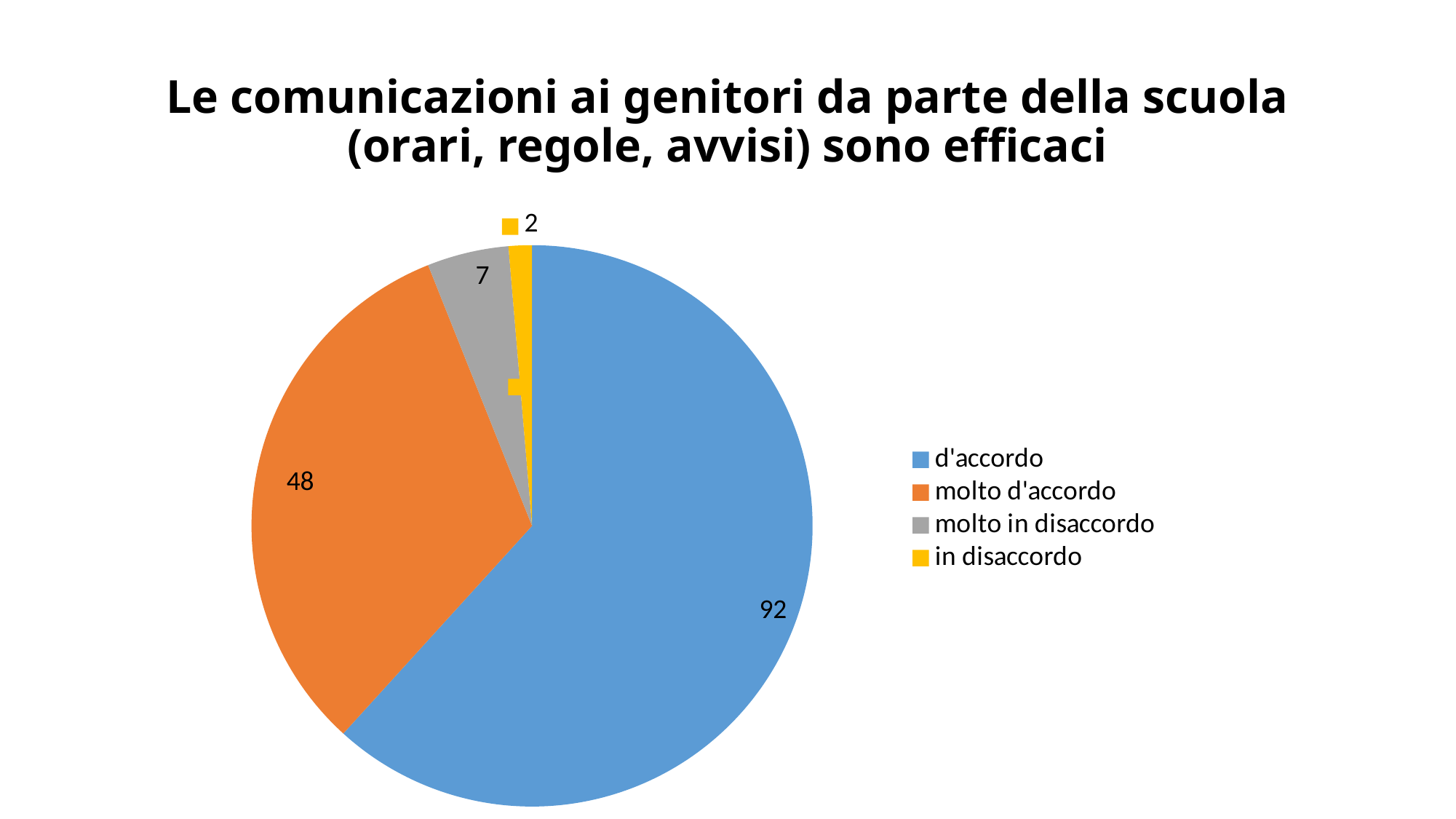
Which is larger, the value for "molto in disaccordo" or the value for "in disaccordo"? molto in disaccordo What is the value for "d'accordo"? 92 What is the value for "in disaccordo"? 2 Which category has the smallest slice? in disaccordo What is the difference between the values for "d'accordo" and "molto d'accordo"? 44 What is the total of all the slices in the pie chart? 149 What type of chart is shown on the slide? pie chart Which category has the largest slice? d'accordo What is the value for "molto in disaccordo"? 7 How many categories does the pie chart have? 4 What colour is the slice for "molto d'accordo"? orange What is the value for "molto d'accordo"? 48